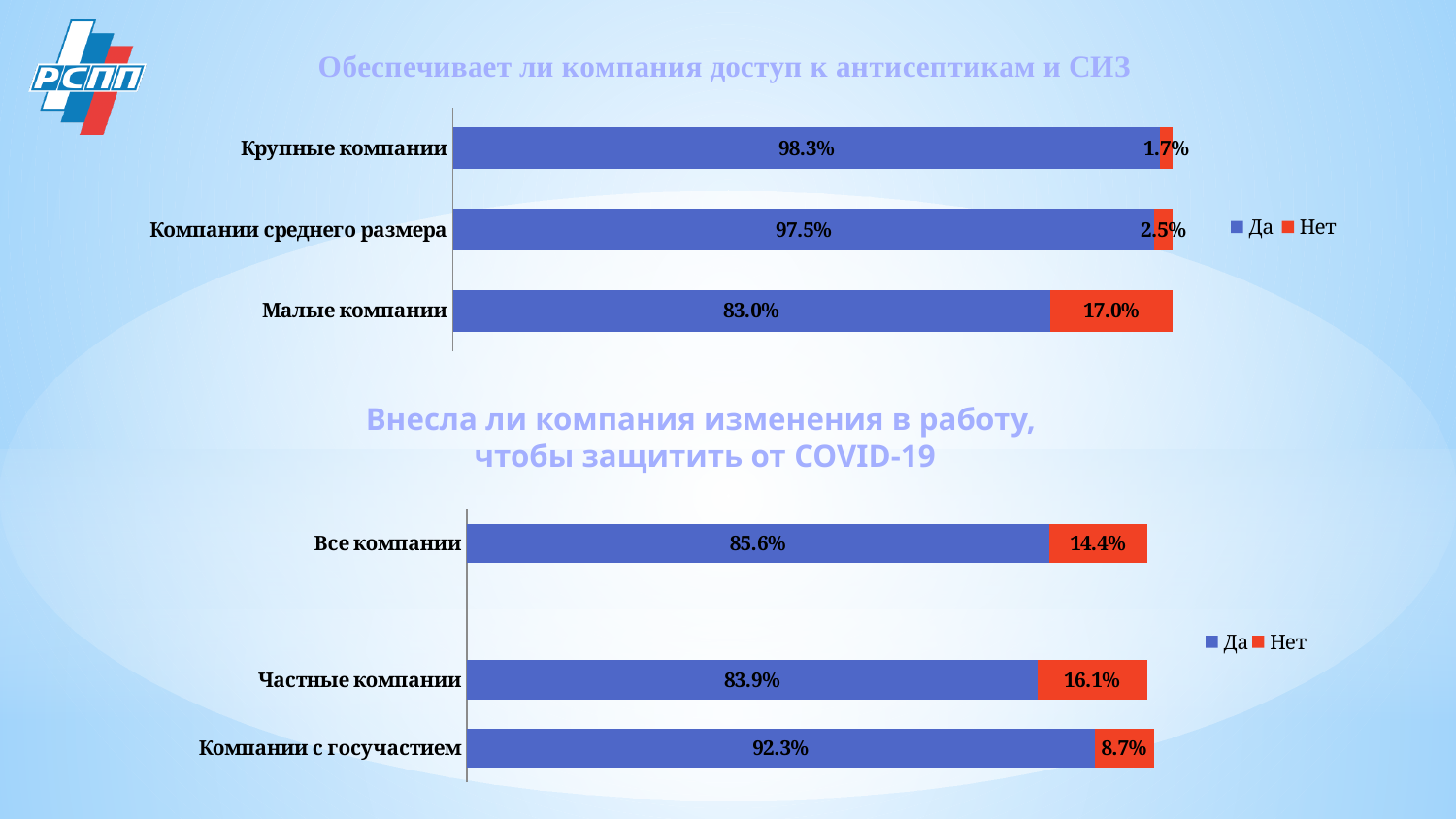
In the bottom chart (Внесла ли компания изменения в работу, чтобы защитить от COVID-19), what is the 'Нет' value for Частные компании? 16.1% In the bottom chart (Внесла ли компания изменения в работу, чтобы защитить от COVID-19), what is the total of the stacked bar for Все компании? 100.0% In the bottom chart (Внесла ли компания изменения в работу, чтобы защитить от COVID-19), what is the 'Да' value for Компании с госучастием? 92.3% In the top chart (Обеспечивает ли компания доступ к антисептикам и СИЗ), how many series does the legend list? 2 In the top chart (Обеспечивает ли компания доступ к антисептикам и СИЗ), what is the 'Нет' value for Малые компании? 17.0% In the top chart (Обеспечивает ли компания доступ к антисептикам и СИЗ), which category has the lowest 'Да' value? Малые компании What kind of chart is the bottom chart (Внесла ли компания изменения в работу, чтобы защитить от COVID-19)? Stacked bar chart In the top chart (Обеспечивает ли компания доступ к антисептикам и СИЗ), what is the difference between the 'Нет' values for Малые компании and Крупные компании? 15.3% In the top chart (Обеспечивает ли компания доступ к антисептикам и СИЗ), how many categories are shown? 3 In the bottom chart (Внесла ли компания изменения в работу, чтобы защитить от COVID-19), which category has the highest 'Да' value? Компании с госучастием In the bottom chart (Внесла ли компания изменения в работу, чтобы защитить от COVID-19), which is larger: the 'Нет' value for Все компании or for Частные компании? Частные компании In the top chart (Обеспечивает ли компания доступ к антисептикам и СИЗ), what is the 'Да' value for Крупные компании? 98.3%